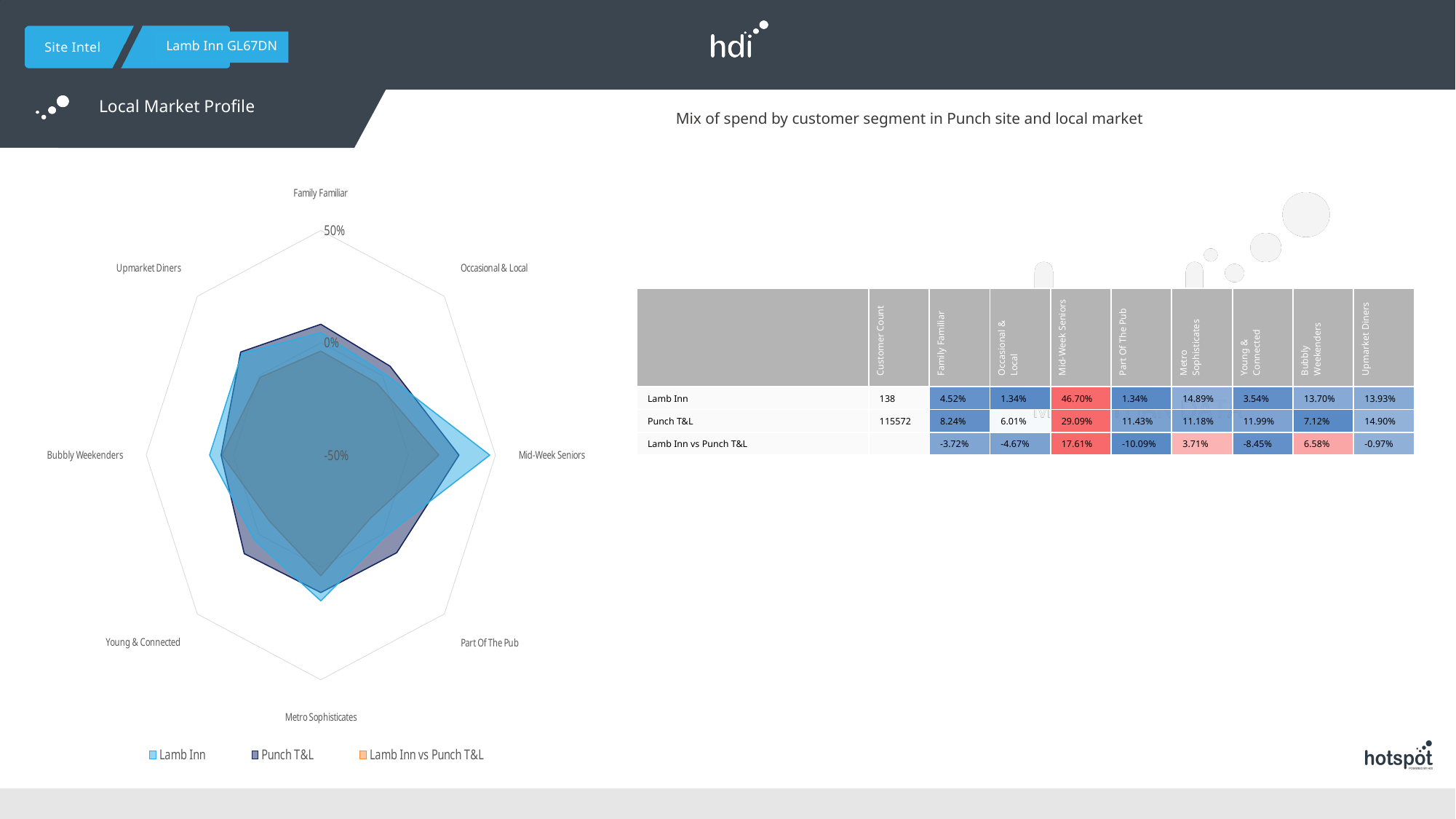
For Bubbly Weekenders, which is larger: Lamb Inn or Punch T&L? Lamb Inn What type of chart is shown on the left of the slide? Radar chart Which customer segment has the highest Lamb Inn value? Mid-Week Seniors How many series does the radar chart's legend list? 3 What is the highest percentage label shown on the radar chart's axis? 50% What is the Punch T&L value for Upmarket Diners? 14.90% How many customer segments are plotted around the radar chart? 8 What is the Customer Count for Lamb Inn? 138 What is the difference between Lamb Inn and Punch T&L for Mid-Week Seniors? 17.61% What is the Lamb Inn value for Mid-Week Seniors? 46.70% Which customer segment has the lowest Punch T&L value? Occasional & Local What is the Lamb Inn vs Punch T&L value for Part Of The Pub? -10.09%